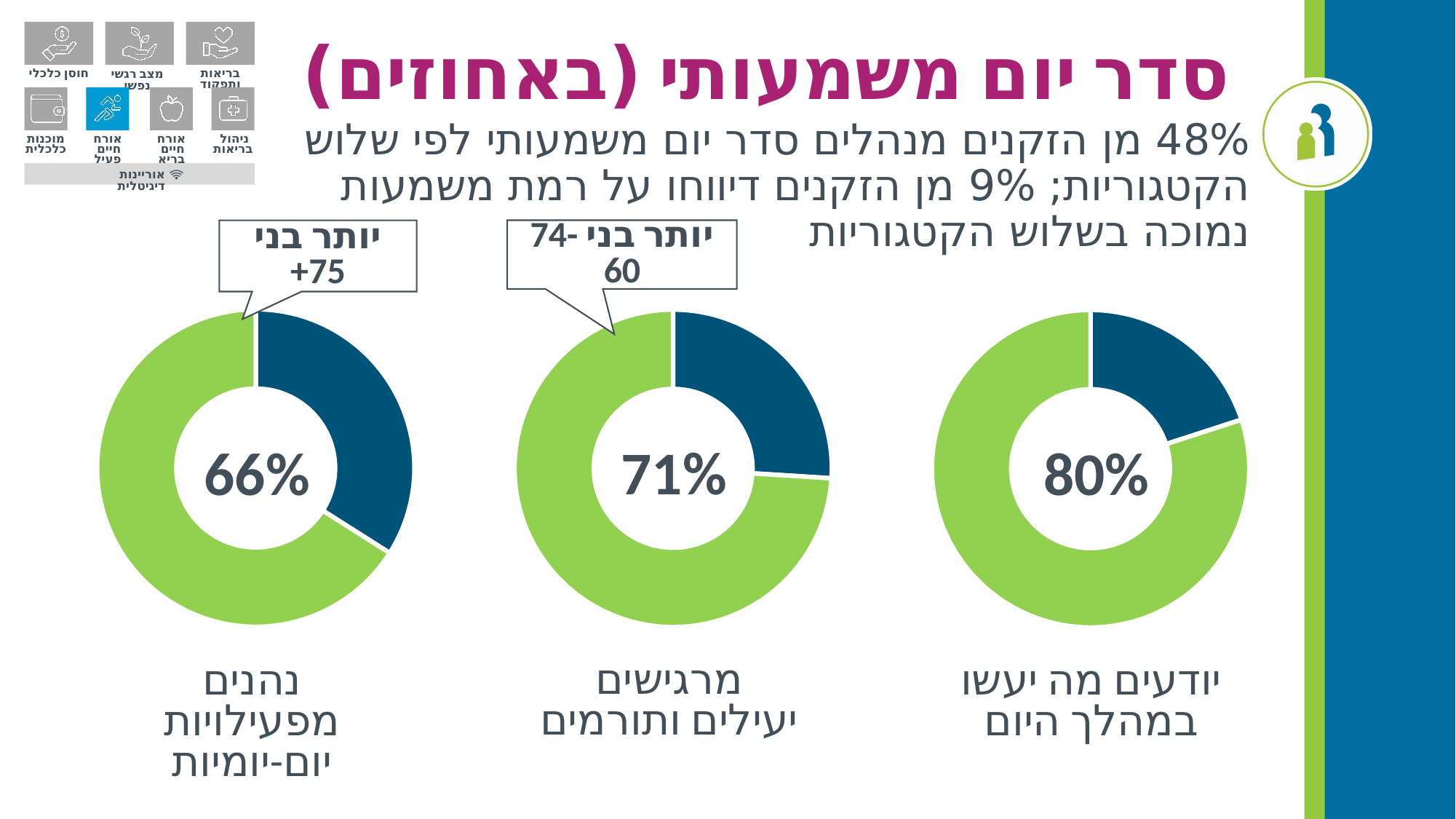
Which age group does the callout above the middle donut chart ('מרגישים יעילים ותורמים') refer to? יותר בני 60-74 Which of the three donut charts shows the highest percentage? יודעים מה יעשו במהלך היום (80%) Which of the three donut charts shows the lowest percentage? נהנים מפעילויות יום-יומיות (66%) What is the difference between the percentage in the 'מרגישים יעילים ותורמים' chart and the percentage in the 'נהנים מפעילויות יום-יומיות' chart? 5% Which is larger: the percentage in the 'מרגישים יעילים ותורמים' chart or the percentage in the 'יודעים מה יעשו במהלך היום' chart? יודעים מה יעשו במהלך היום In the donut chart labelled 'מרגישים יעילים ותורמים', what percentage is shown in the centre? 71% In the donut chart labelled 'יודעים מה יעשו במהלך היום', what percentage is shown in the centre? 80% Which age group does the callout above the leftmost donut chart ('נהנים מפעילויות יום-יומיות') refer to? יותר בני 75+ In the donut chart labelled 'נהנים מפעילויות יום-יומיות', what percentage is shown in the centre? 66% How many donut charts are shown on the slide? 3 What is the difference between the percentage in the 'יודעים מה יעשו במהלך היום' chart and the percentage in the 'נהנים מפעילויות יום-יומיות' chart? 14% What kind of charts are shown on the slide? Donut (pie) charts